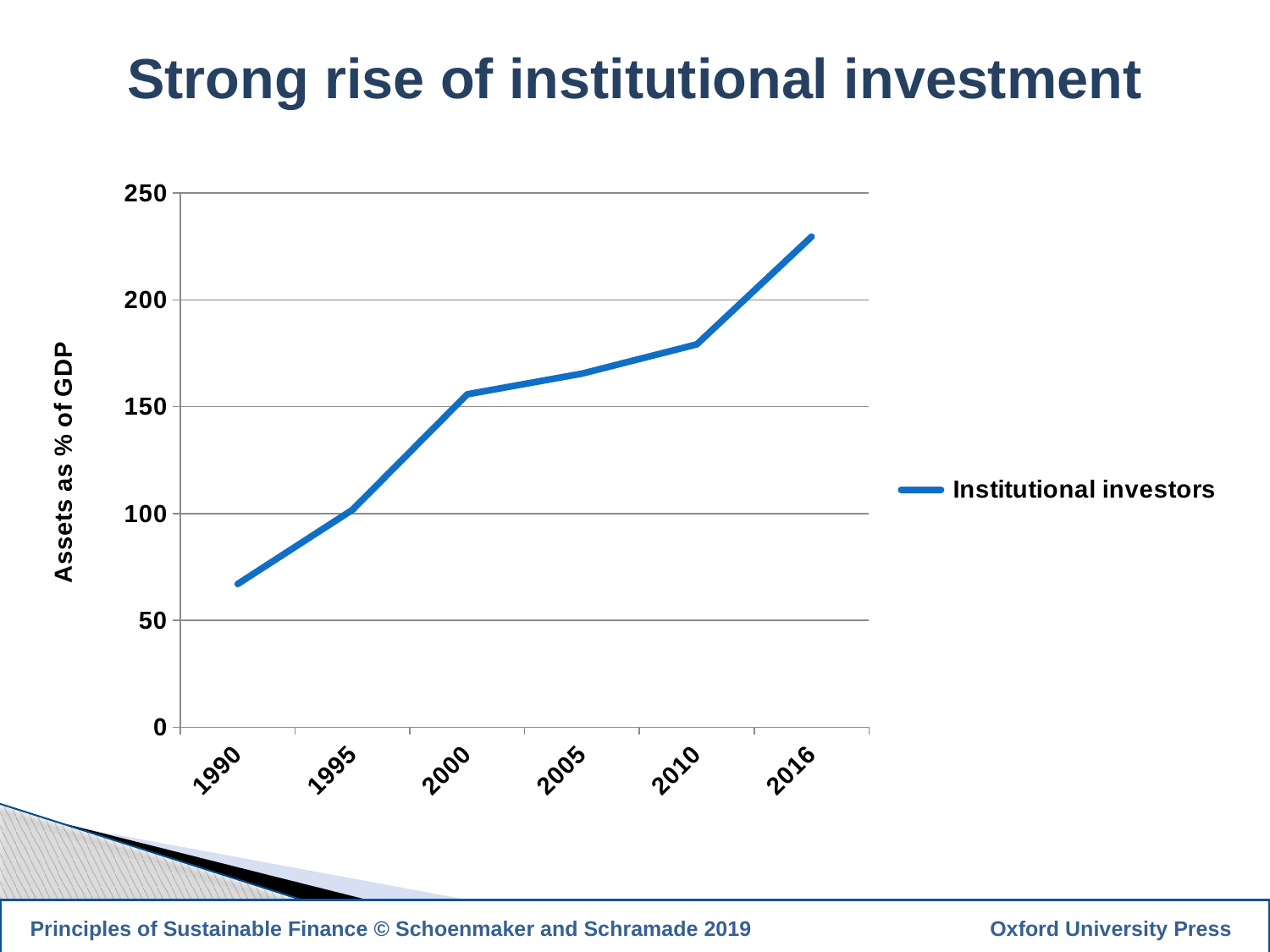
Do the values rise or fall from 1990 to 2016? rise Is the value for 2000 greater or less than 150? greater How many series does the legend list? 1 What is the name of the series shown in the legend? Institutional investors Is the value for 2016 greater or less than 200? greater What kind of chart is shown on the slide? line chart Which year has the lowest value for Institutional investors? 1990 Is the value for 1990 greater or less than 100? less Which year has the larger value, 2005 or 2010? 2010 Which year has the highest value for Institutional investors? 2016 What is the label of the vertical axis? Assets as % of GDP How many years are plotted along the x axis? 6